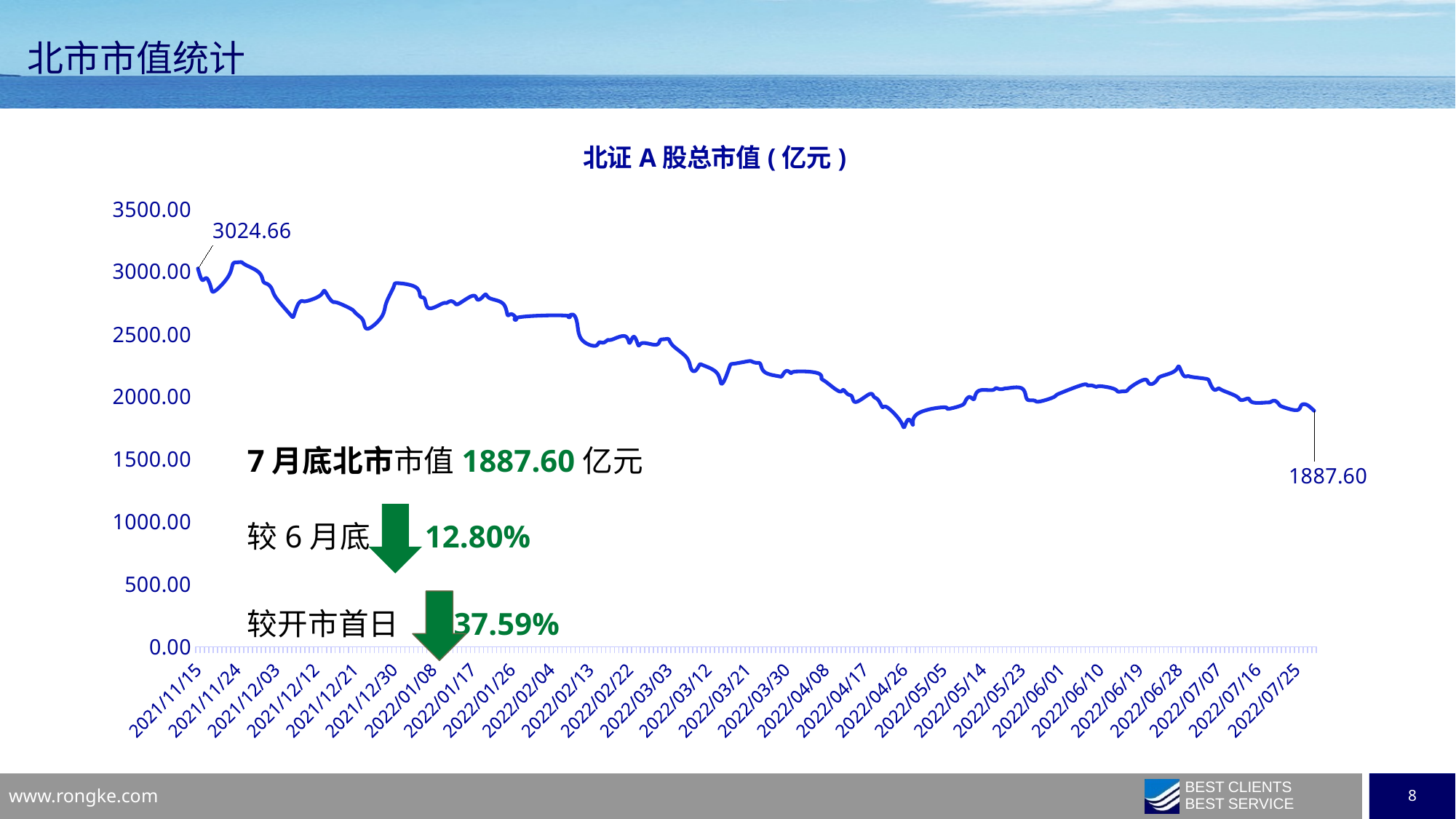
Overall, do the values rise or fall from left to right along the x axis? fall Is the value around 2021/12/30 greater or less than 2500? greater Which is larger, the value at the start of the series (3024.66) or the value at the end (1887.60)? 3024.66 (the start) Is the value around 2022/06/28 greater or less than 2000? greater What is the title of the chart? 北证A股总市值(亿元) What is the data label shown at the start of the line (2021/11/15)? 3024.66 Is the value around 2022/04/26 greater or less than 2000? less What is the highest tick value shown on the y axis? 3500.00 How many data series are plotted in the chart? 1 What kind of chart is shown on the slide? line chart What is the difference between the first labelled value (3024.66) and the last labelled value (1887.60)? 1137.06 What is the data label shown at the end of the line (late July 2022)? 1887.60